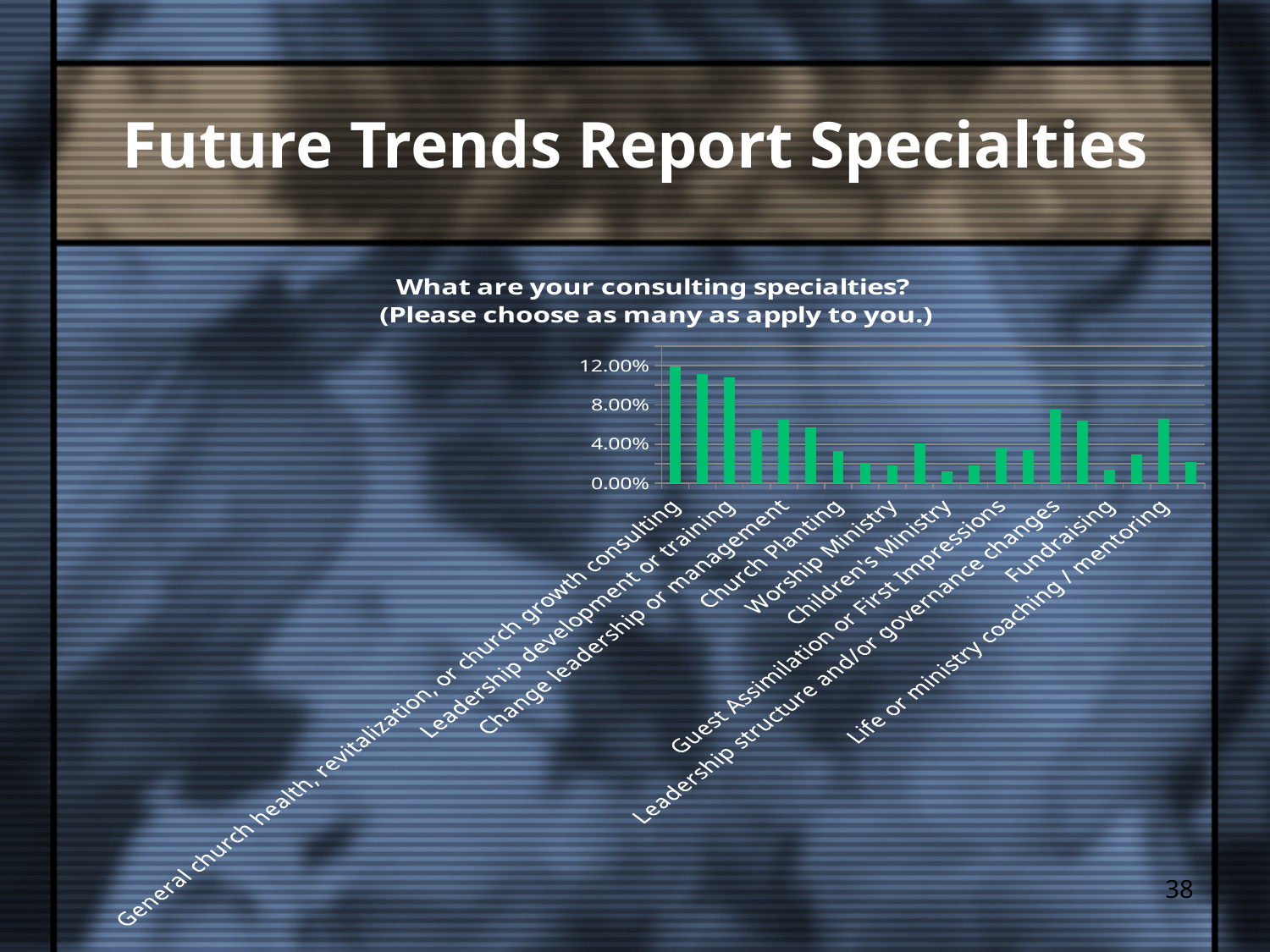
Is the value for Children's Ministry greater or less than 4.00%? less What kind of chart is shown on the slide? bar chart Which is larger, the value for General church health, revitalization, or church growth consulting or the value for Fundraising? General church health, revitalization, or church growth consulting Is the value for Fundraising greater or less than 4.00%? less Is the value for General church health, revitalization, or church growth consulting greater or less than 8.00%? greater What is the highest value shown on the chart's vertical axis? 12.00% Which category has the highest value in the chart? General church health, revitalization, or church growth consulting What is the title of the chart? What are your consulting specialties? (Please choose as many as apply to you.) Which is larger, the value for Leadership development or training or the value for Children's Ministry? Leadership development or training